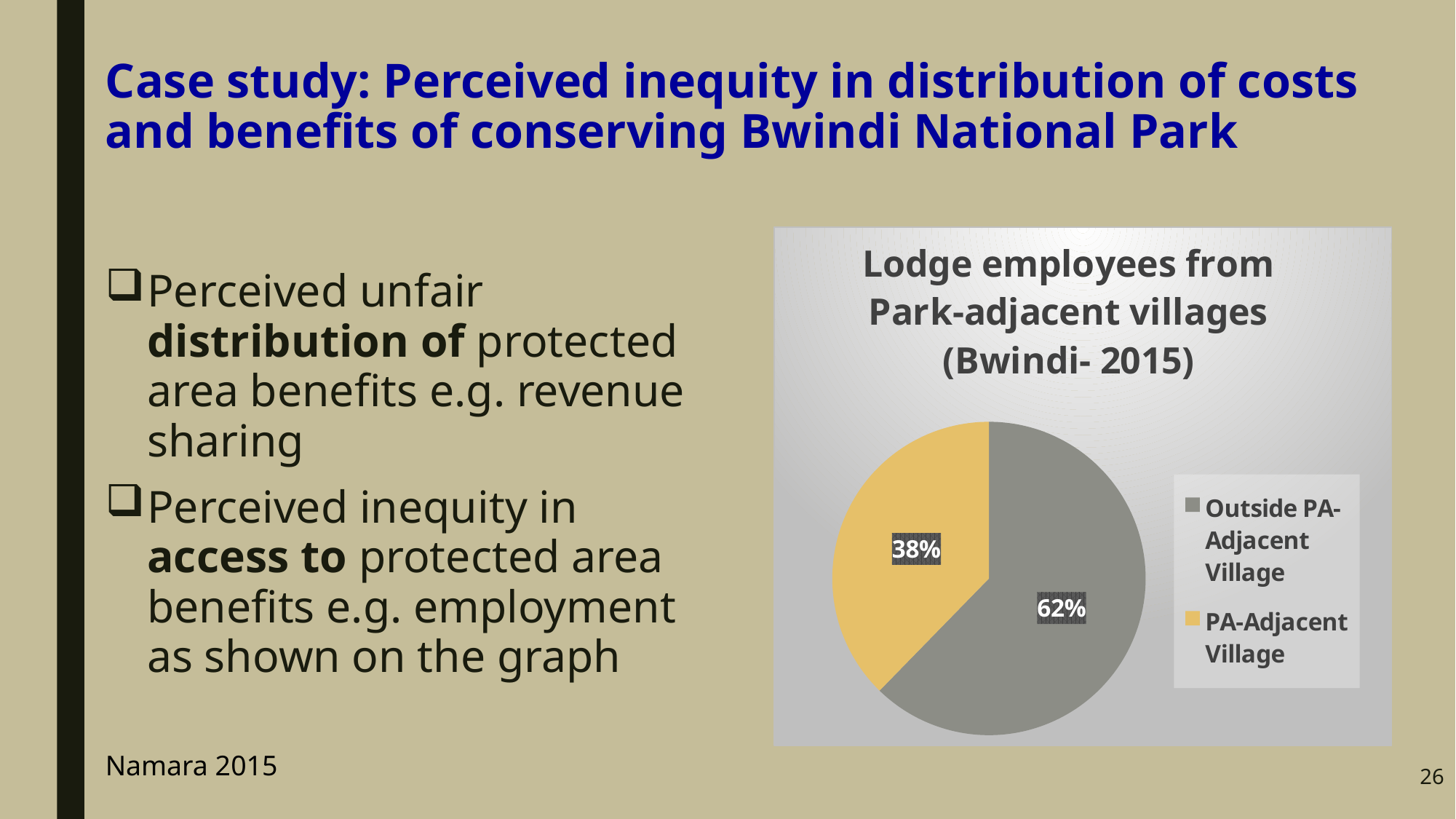
What percentage of lodge employees come from PA-Adjacent Village? 38% What kind of chart is shown on the slide? pie chart How many slices does the pie chart have? 2 Which is larger: the share for PA-Adjacent Village or the share for Outside PA-Adjacent Village? Outside PA-Adjacent Village What is the title of the chart? Lodge employees from Park-adjacent villages (Bwindi- 2015) What share of the pie does the PA-Adjacent Village slice represent? 38% Which category has the smallest share of the pie? PA-Adjacent Village What colour is the slice for PA-Adjacent Village? yellow Which category has the largest share of the pie? Outside PA-Adjacent Village How many entries does the legend list? 2 What is the difference in percentage points between the Outside PA-Adjacent Village share and the PA-Adjacent Village share? 24 What percentage of lodge employees come from Outside PA-Adjacent Village? 62%